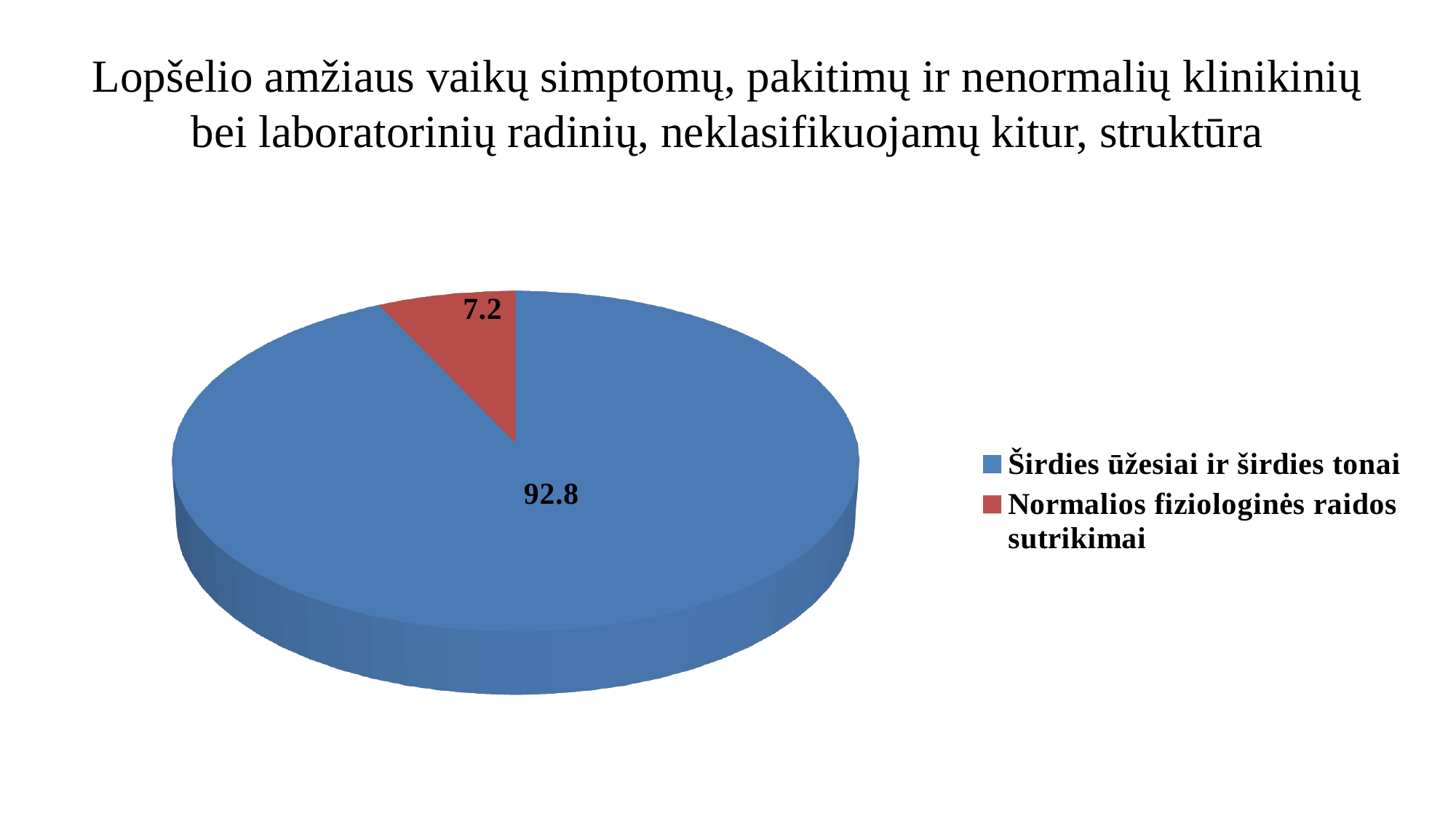
Which is larger, the value for Širdies ūžesiai ir širdies tonai or for Normalios fiziologinės raidos sutrikimai? Širdies ūžesiai ir širdies tonai Which category has the largest slice? Širdies ūžesiai ir širdies tonai Which category has the smallest slice? Normalios fiziologinės raidos sutrikimai How many entries does the legend list? 2 What colour is the slice for Širdies ūžesiai ir širdies tonai? blue What kind of chart is shown on the slide? pie chart What is the value for Normalios fiziologinės raidos sutrikimai? 7.2 How many slices does the pie chart have? 2 What colour is the slice for Normalios fiziologinės raidos sutrikimai? red What is the difference between the values for Širdies ūžesiai ir širdies tonai and Normalios fiziologinės raidos sutrikimai? 85.6 What is the value for Širdies ūžesiai ir širdies tonai? 92.8